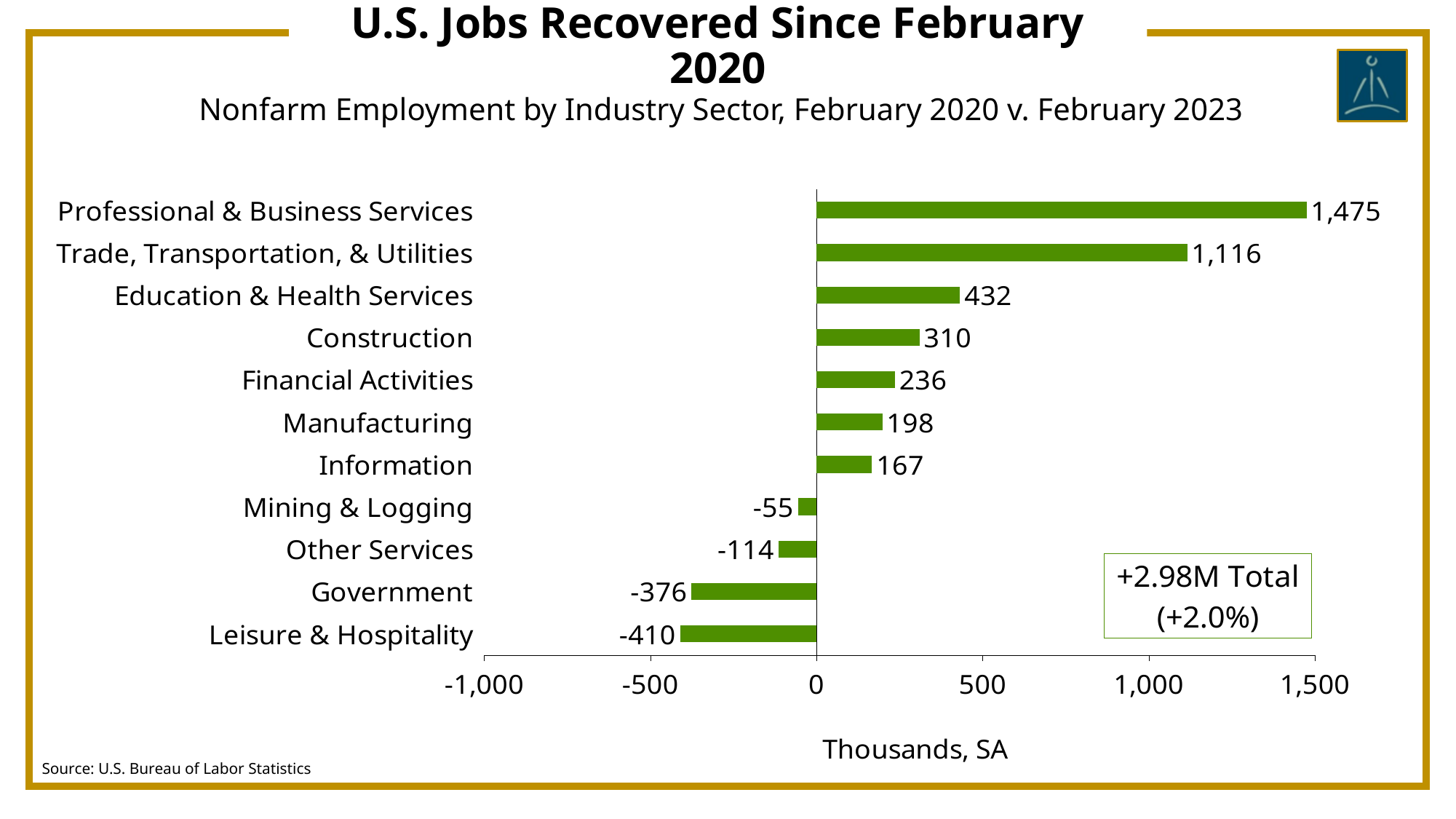
What is the value for Leisure & Hospitality? -410 What total is shown in the text box on the chart? +2.98M Total (+2.0%) Which is larger, the value for Construction or the value for Financial Activities? Construction What is the value for Manufacturing? 198 Which industry sector has the highest value? Professional & Business Services What is the value for Professional & Business Services? 1,475 What unit is shown on the x axis of the chart? Thousands, SA What is the difference between the values for Professional & Business Services and Trade, Transportation, & Utilities? 359 Which industry sector has the lowest value? Leisure & Hospitality What kind of chart is shown on the slide? bar chart Is the value for Education & Health Services greater or less than 500? less How many industry sectors are shown in the chart? 11